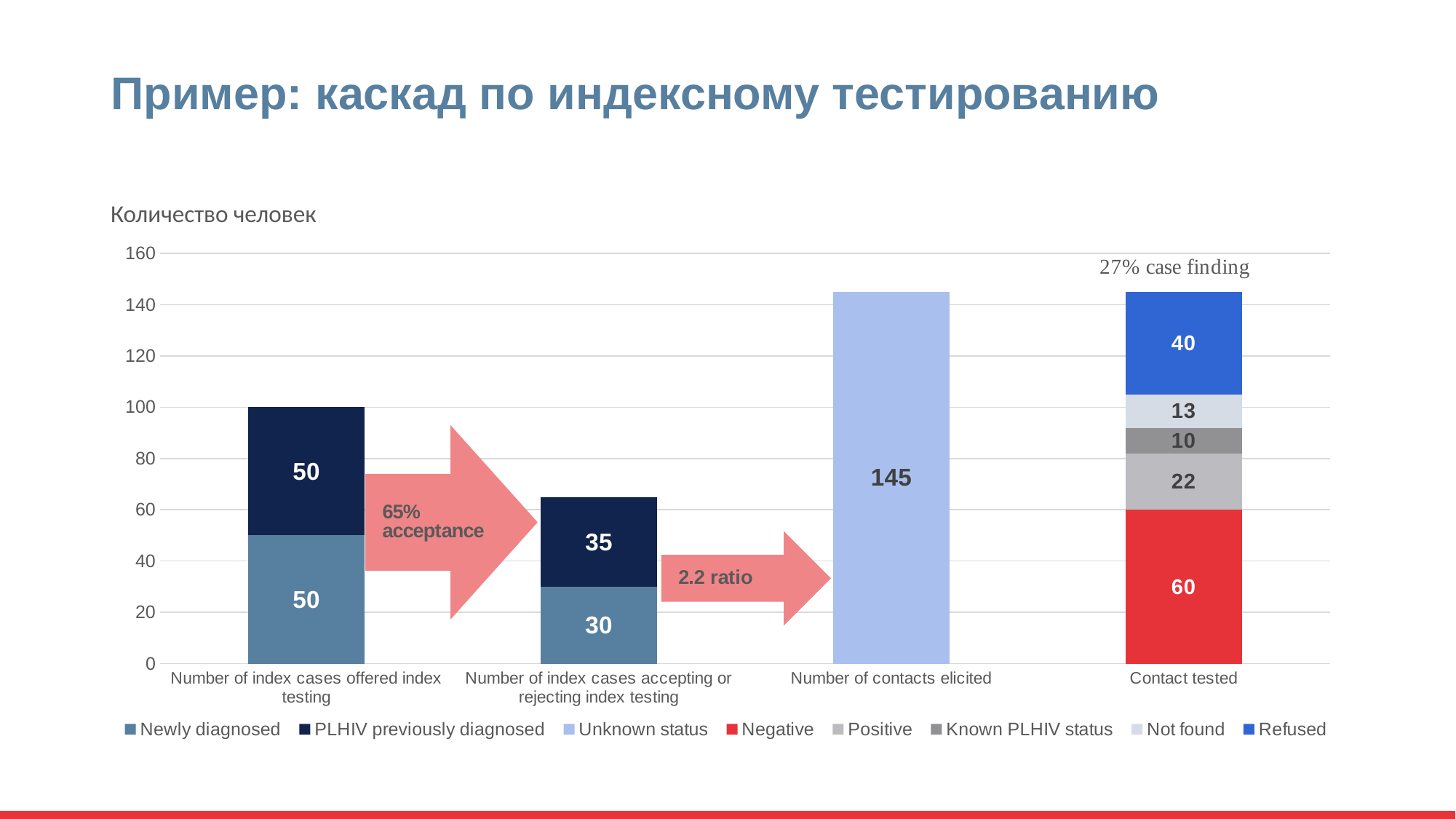
What is the total of the 'Contact tested' stacked bar? 145 What is the difference between the Negative value (60) and the Positive value (22) in the 'Contact tested' bar? 38 How many series does the legend list? 8 What is the value for Refused in the 'Contact tested' bar? 40 How many categories are shown on the x axis? 4 What is the value for Newly diagnosed in the 'Number of index cases offered index testing' bar? 50 What is the total of the 'Number of index cases accepting or rejecting index testing' stacked bar? 65 What is the value for Unknown status in the 'Number of contacts elicited' bar? 145 What is the value for Negative in the 'Contact tested' bar? 60 What type of chart is shown on the slide? stacked bar chart What is the value for PLHIV previously diagnosed in the 'Number of index cases accepting or rejecting index testing' bar? 35 Which is larger in the 'Contact tested' bar: Not found or Known PLHIV status? Not found